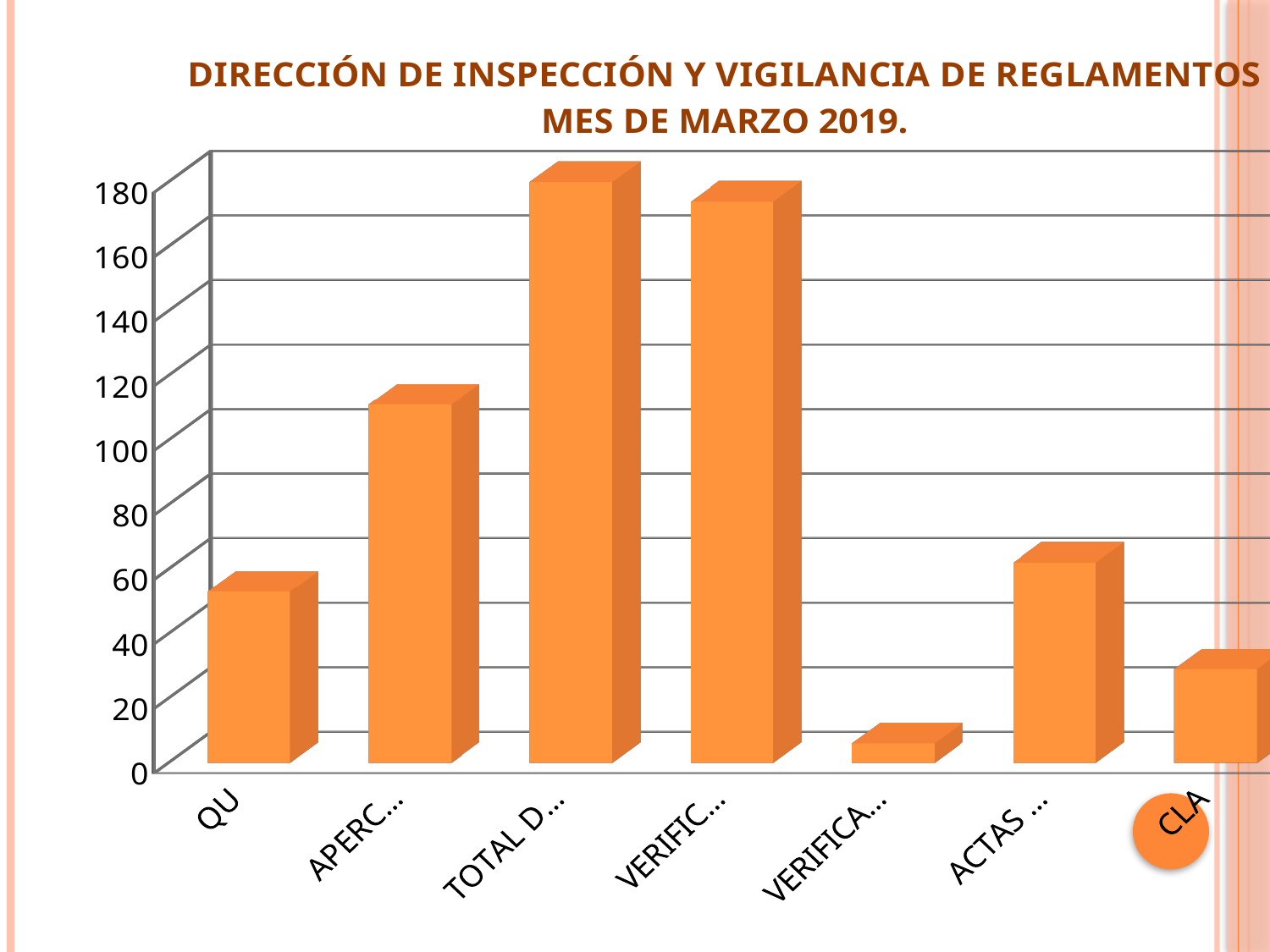
Is the value for the first bar (QU) greater or less than 40? greater Is the value for the last bar (CLA) greater or less than 40? less How many bars does the chart contain? 7 Is the value for the third bar (TOTAL D...) greater or less than 160? greater Which is larger, the value for the first bar (QU) or the second bar (APERC...)? APERC... Which is larger, the value for the sixth bar (ACTAS ...) or the last bar (CLA)? ACTAS ... What is the title of the chart? DIRECCIÓN DE INSPECCIÓN Y VIGILANCIA DE REGLAMENTOS MES DE MARZO 2019. What kind of chart is shown on the slide? Bar chart Which category has the lowest bar in the chart? VERIFICA... (the fifth bar)